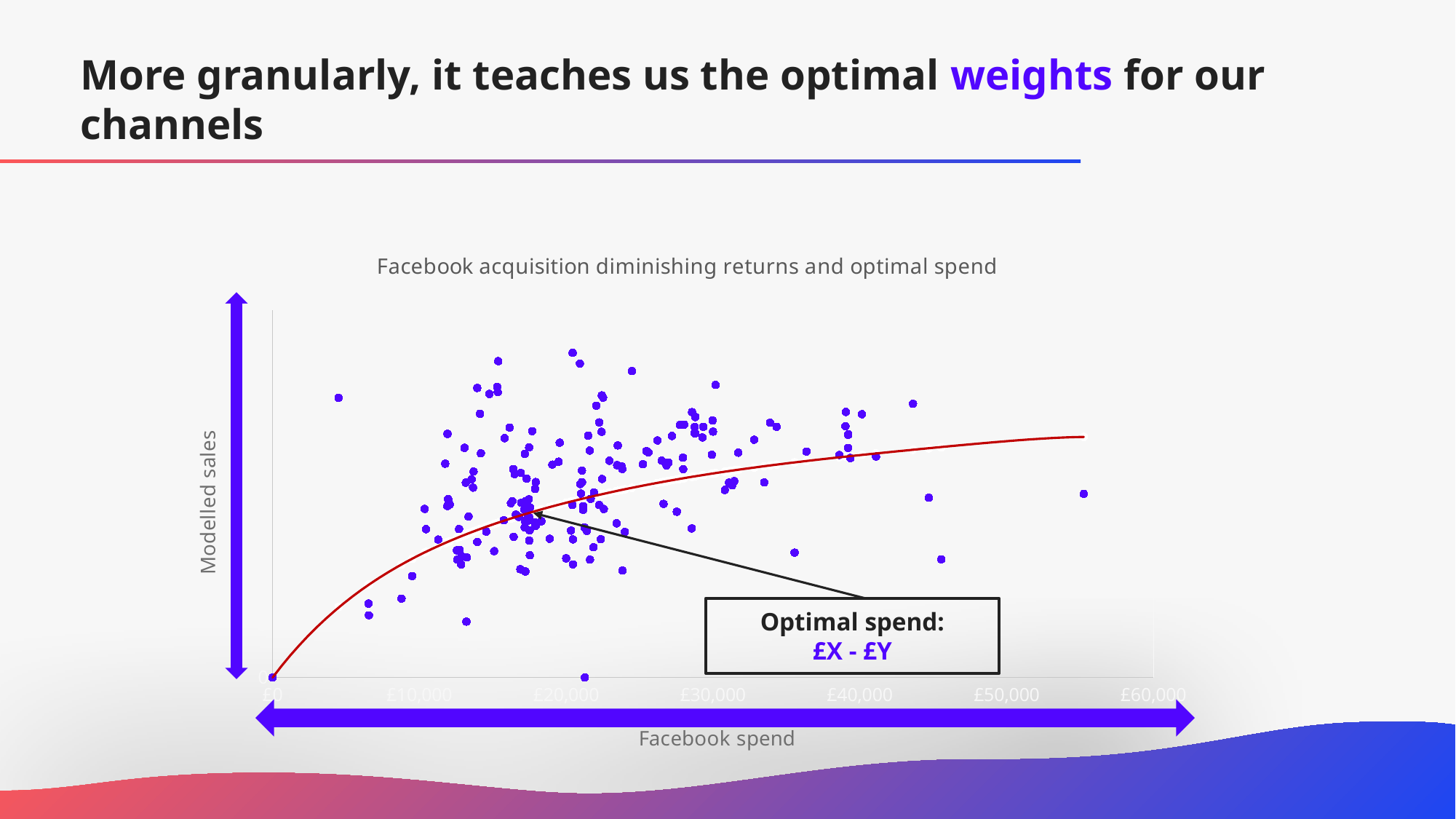
What is the title of the chart? Facebook acquisition diminishing returns and optimal spend Does the red curve rise more steeply between £0 and £10,000 or between £50,000 and £60,000? Between £0 and £10,000 What is the label of the horizontal axis of the chart? Facebook spend What is the highest tick label shown on the horizontal axis? £60,000 What optimal spend range does the annotation box on the chart give? £X - £Y What is the lowest tick label shown on the horizontal axis? £0 Does the fitted red curve rise or fall as Facebook spend increases? Rises What kind of chart is shown on the slide? Scatter chart How many tick labels are shown on the horizontal axis? 7